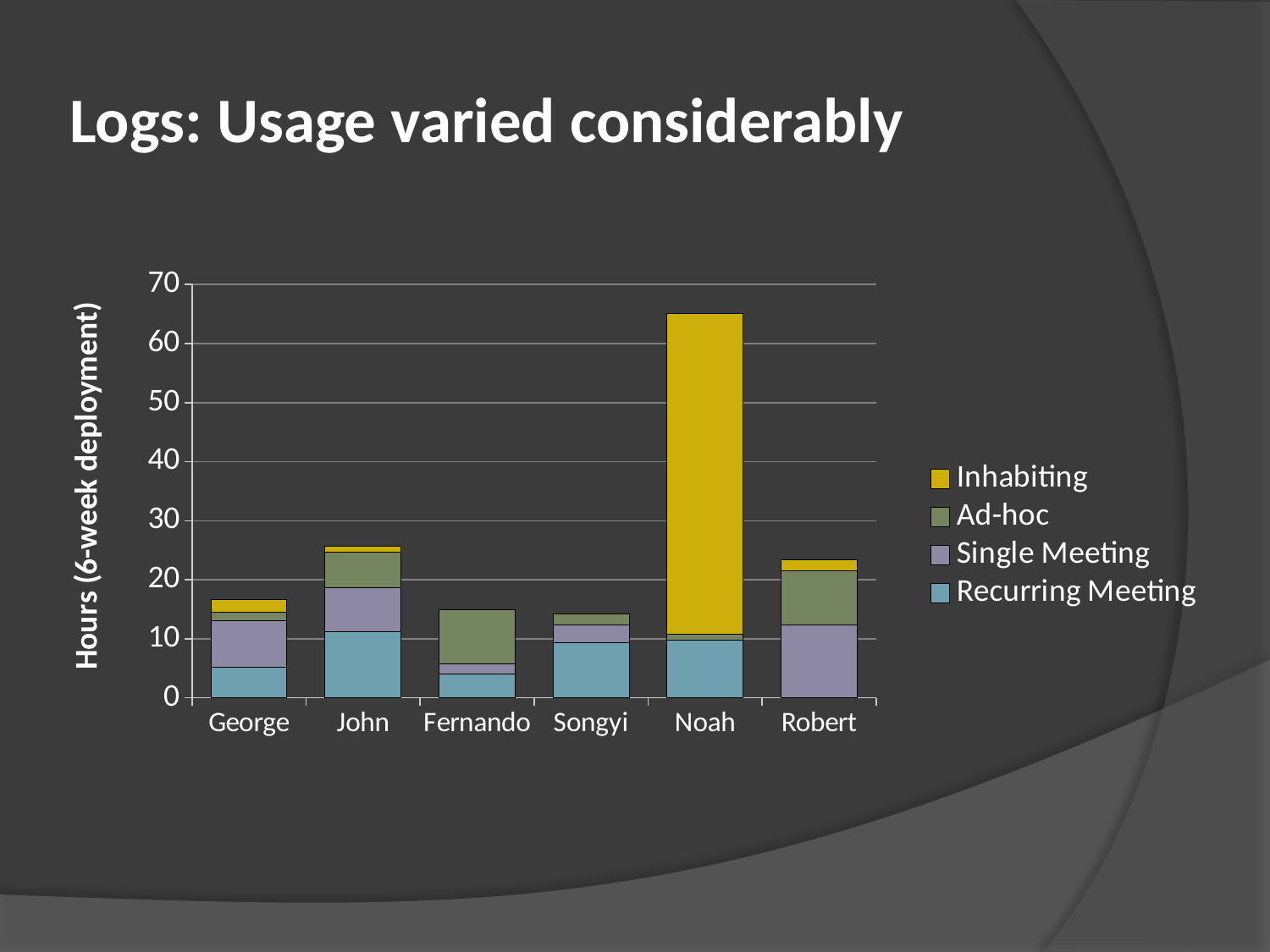
What is the title of the y axis? Hours (6-week deployment) Which has a larger total, John or Songyi? John Is the total value for John greater or less than 20? greater Is the total value for Fernando greater or less than 20? less Is the total value for Noah greater or less than 60? greater How many people (categories) are shown on the x axis? 6 Which has a larger total, Noah or George? Noah Which person has the largest Inhabiting segment? Noah Which person has the highest total hours? Noah What kind of chart is shown on the slide? Stacked bar chart How many series does the legend list? 4